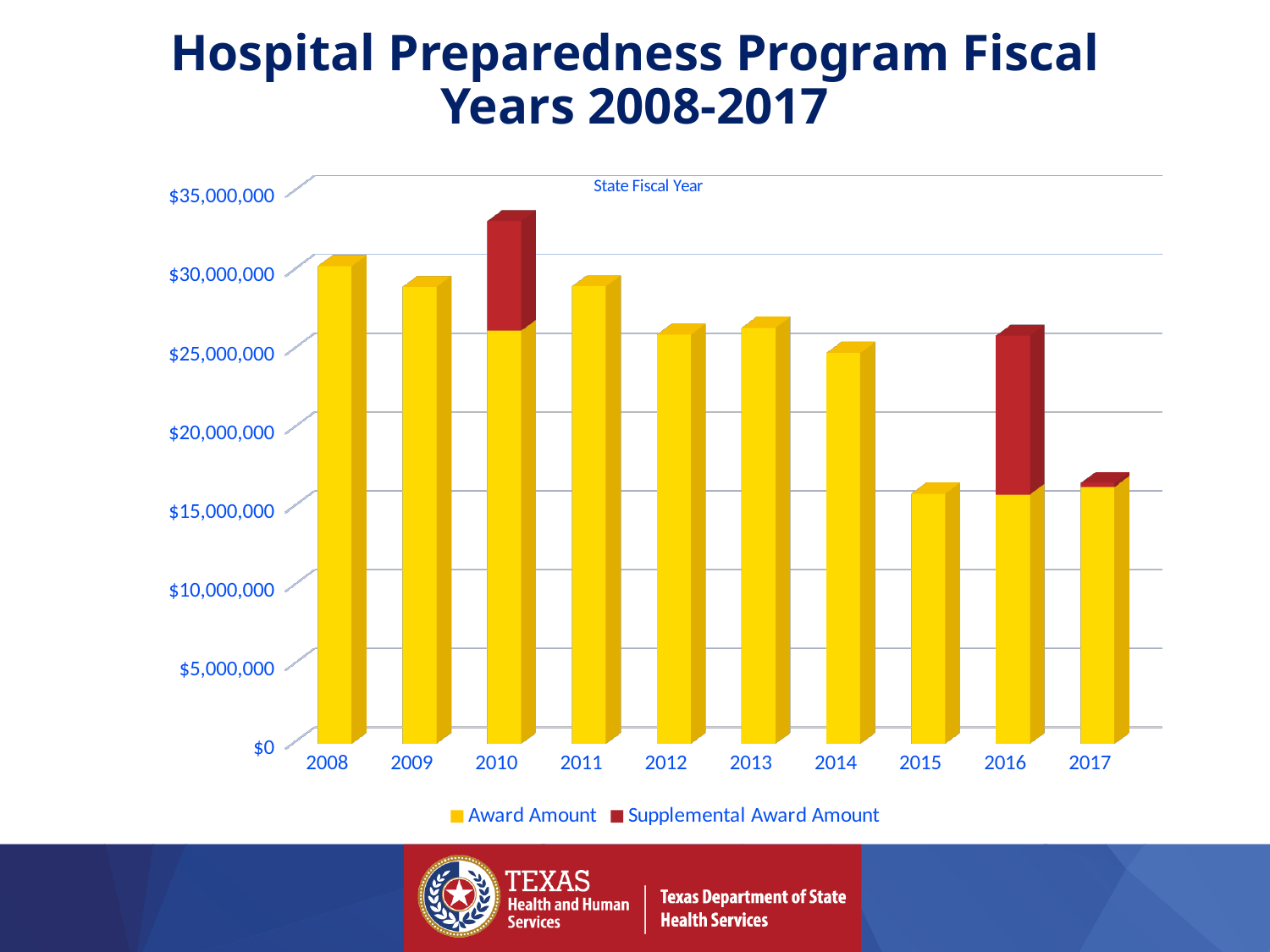
Which fiscal year has the highest Award Amount (yellow portion only)? 2008 Which is larger, the Supplemental Award Amount for 2016 or for 2010? 2016 Is the Award Amount for 2015 greater or less than $20,000,000? less What kind of chart is shown on the slide? Bar chart How many fiscal years are shown on the x axis of the chart? 10 Which is larger, the Award Amount for 2008 or the Award Amount for 2015? 2008 Overall, do the Award Amounts rise or fall from 2008 to 2017? fall How many series does the chart's legend list? 2 Is the Award Amount for 2009 greater or less than $25,000,000? greater Is the Award Amount for 2011 greater or less than $30,000,000? less Which fiscal year has the tallest total bar (award plus supplemental)? 2010